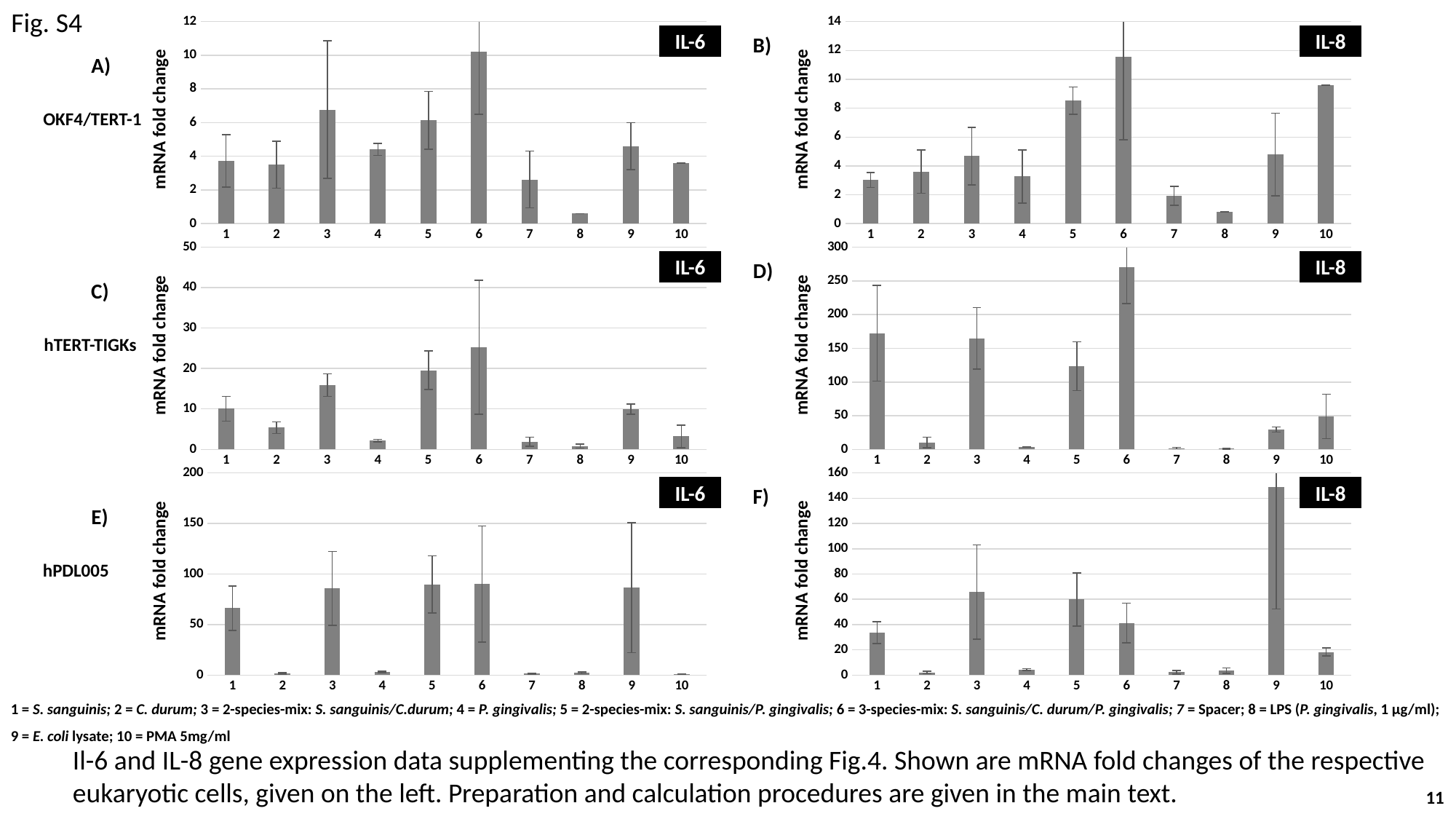
In chart B (IL-8, OKF4/TERT-1), is the value for category 10 greater or less than 8? greater In chart A (IL-6, OKF4/TERT-1), which category has the highest mRNA fold change? 6 In chart E (IL-6, hPDL005), is the value for category 1 greater or less than 50? greater In chart D (IL-8, hTERT-TIGKs), is the value for category 6 greater or less than 250? greater In chart A (IL-6, OKF4/TERT-1), which category has the lowest mRNA fold change? 8 In chart F (IL-8, hPDL005), which category has the highest mRNA fold change? 9 In chart B (IL-8, OKF4/TERT-1), which category has the highest mRNA fold change? 6 How many categories are shown on the x axis of chart F (IL-8, hPDL005)? 10 In chart C (IL-6, hTERT-TIGKs), which is larger, the value for category 3 or the value for category 2? category 3